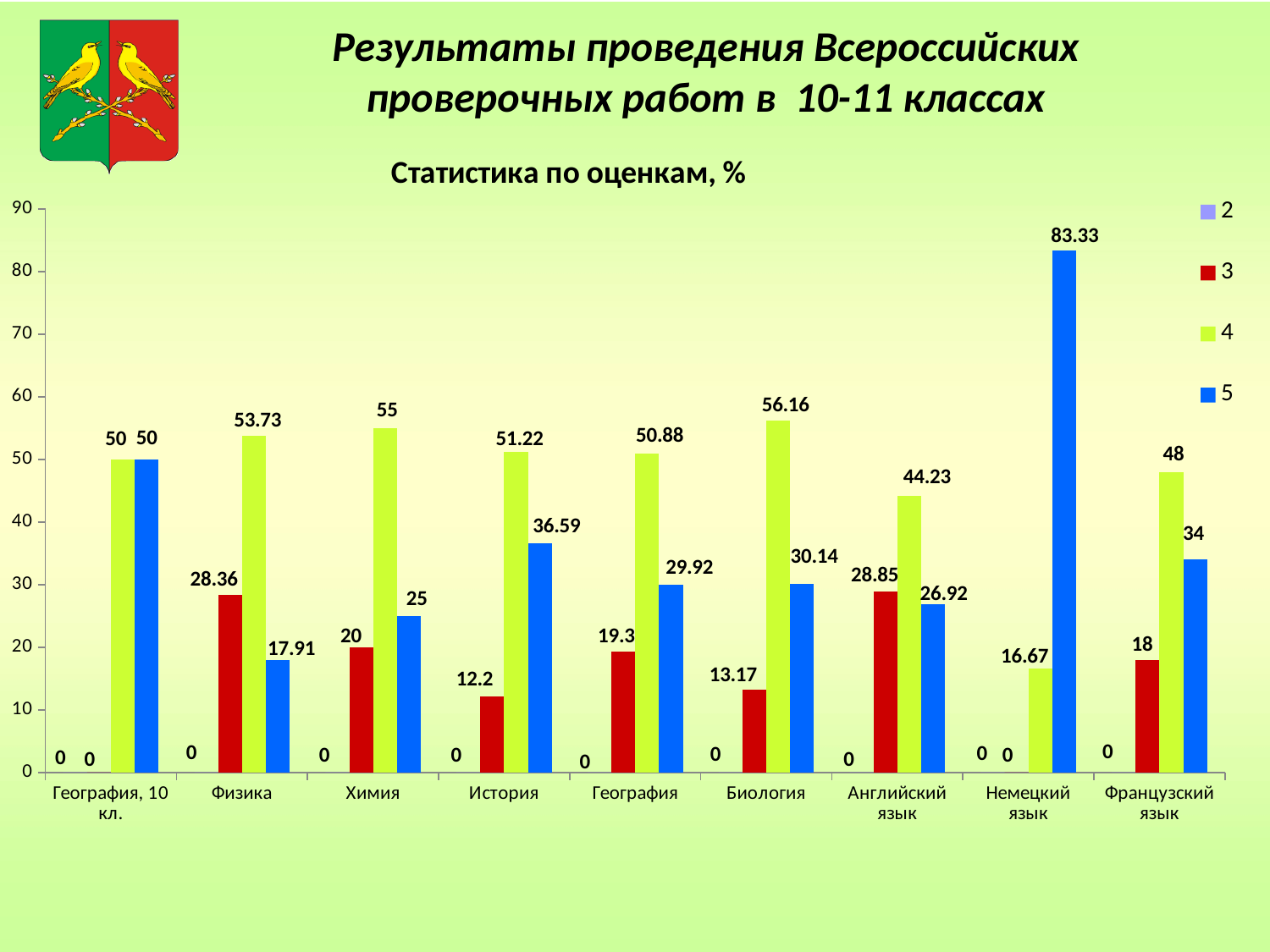
What is the value of series 5 for Немецкий язык? 83.33 What is the title of the chart? Статистика по оценкам, % What is the value of series 4 for Биология? 56.16 Which category has the lowest non-zero value for series 4? Немецкий язык How many categories are shown on the x axis? 9 What kind of chart is shown on the slide? bar chart How many series does the legend list? 4 Which is larger for Английский язык: series 3 or series 5? series 3 Is the value of series 5 for История greater or less than 30? greater What is the value of series 3 for Физика? 28.36 What is the difference between series 4 and series 5 for Французский язык? 14 Which category has the highest value for series 5? Немецкий язык